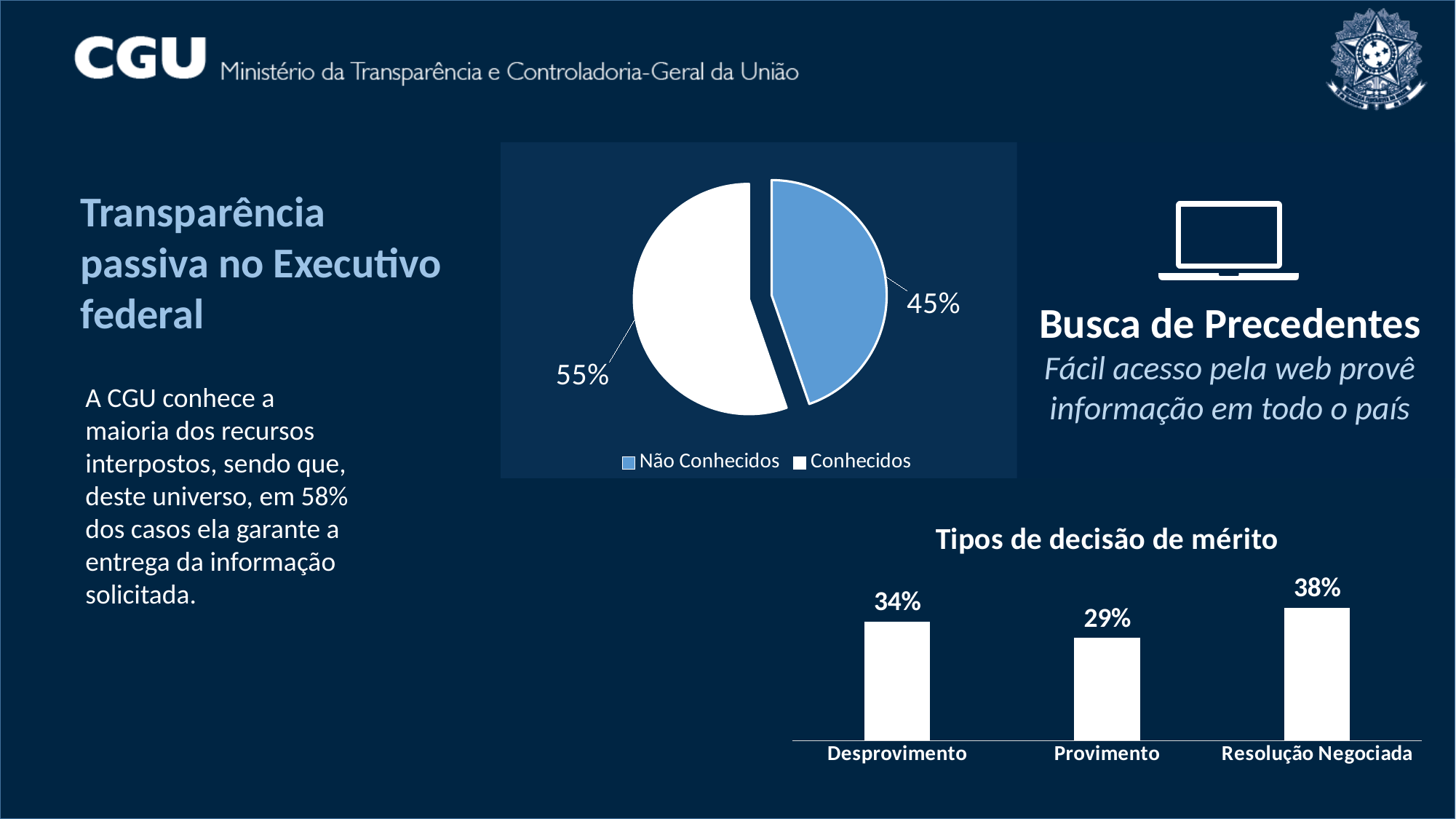
In the pie chart at the top of the slide, what share is labelled for Não Conhecidos? 45% In the chart titled 'Tipos de decisão de mérito', what is the difference between Resolução Negociada and Provimento? 9% In the chart titled 'Tipos de decisão de mérito', what is the value for Provimento? 29% In the chart titled 'Tipos de decisão de mérito', what is the value for Desprovimento? 34% In the pie chart at the top of the slide, how many entries does the legend list? 2 In the chart titled 'Tipos de decisão de mérito', how many categories are shown? 3 In the chart titled 'Tipos de decisão de mérito', which category has the highest value? Resolução Negociada In the pie chart at the top of the slide, what colour is the Não Conhecidos slice? Blue In the pie chart at the top of the slide, what share is labelled for Conhecidos? 55% In the chart titled 'Tipos de decisão de mérito', which category has the lowest value? Provimento What kind of chart is 'Tipos de decisão de mérito'? Bar chart In the pie chart at the top of the slide, which slice is larger, Conhecidos or Não Conhecidos? Conhecidos